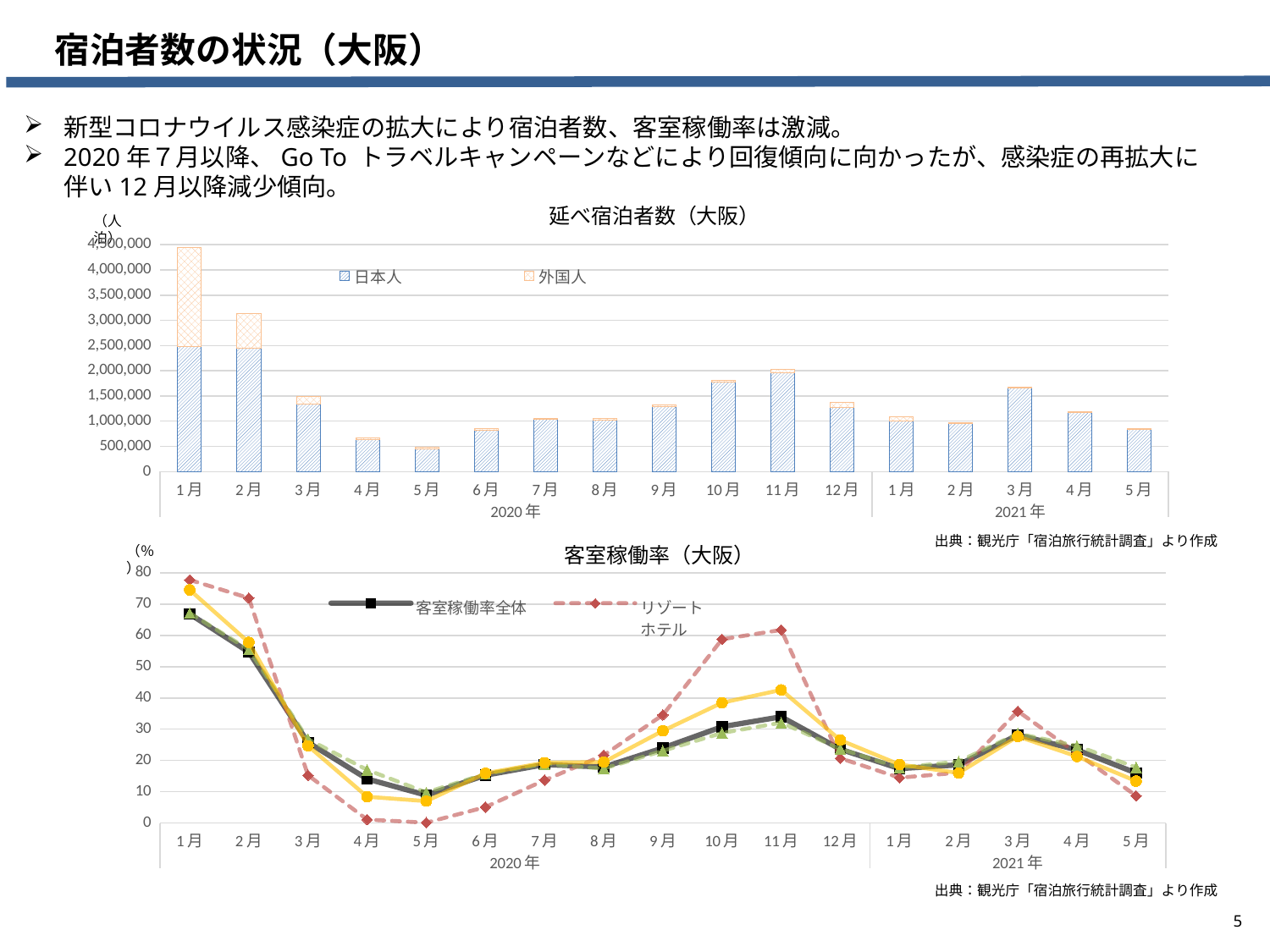
In the bottom chart 客室稼働率（大阪）, which is larger in 2020年10月, リゾートホテル or 客室稼働率全体? リゾートホテル In the top chart 延べ宿泊者数（大阪）, what kind of chart is it? bar chart In the top chart 延べ宿泊者数（大阪）, is the total for 2020年1月 greater or less than 4,000,000? greater In the top chart 延べ宿泊者数（大阪）, which is larger, the total for 2020年10月 or 2020年12月? 2020年10月 In the top chart 延べ宿泊者数（大阪）, which month has the highest total bar? 2020年1月 In the top chart 延べ宿泊者数（大阪）, how many months are shown on the x axis? 17 In the top chart 延べ宿泊者数（大阪）, how many series does the legend list? 2 In the top chart 延べ宿泊者数（大阪）, is the total for 2020年4月 greater or less than 1,000,000? less In the top chart 延べ宿泊者数（大阪）, which month has the lowest total bar? 2020年5月 In the bottom chart 客室稼働率（大阪）, what kind of chart is it? line chart In the bottom chart 客室稼働率（大阪）, is the value of リゾートホテル for 2020年4月 greater or less than 10? less In the bottom chart 客室稼働率（大阪）, does 客室稼働率全体 rise or fall from 2020年1月 to 2020年5月? fall